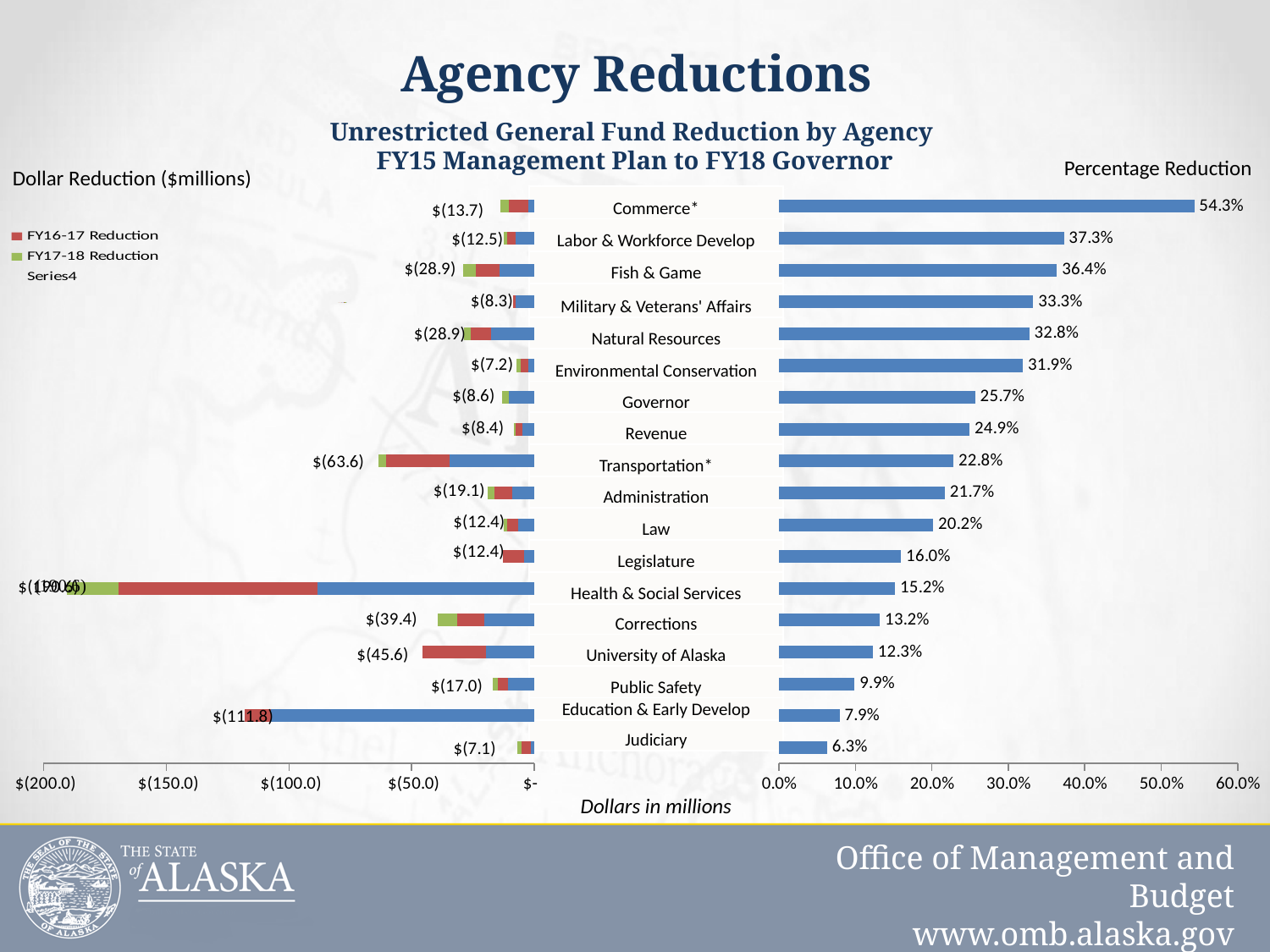
In the Percentage Reduction chart, which agency has the lowest percentage reduction? Judiciary In the Dollar Reduction ($millions) chart, what is the total dollar reduction labeled for Education & Early Develop? $(111.8) In the Percentage Reduction chart, what is the percentage reduction for Commerce*? 54.3% In the Percentage Reduction chart, what is the difference between the percentage reductions for Commerce* and Labor & Workforce Develop? 17.0% In the Percentage Reduction chart, is the value for Natural Resources greater or less than 30.0%? greater What type of chart is the Percentage Reduction chart? Bar chart In the Percentage Reduction chart, what is the percentage reduction for Judiciary? 6.3% In the Percentage Reduction chart, which agency has the highest percentage reduction? Commerce* In the Percentage Reduction chart, which has a larger percentage reduction, Governor or Law? Governor How many agencies are shown in the Percentage Reduction chart? 18 In the Dollar Reduction ($millions) chart, what is the total dollar reduction labeled for Transportation*? $(63.6) In the Dollar Reduction ($millions) chart, which has a larger dollar reduction, University of Alaska or Corrections? University of Alaska